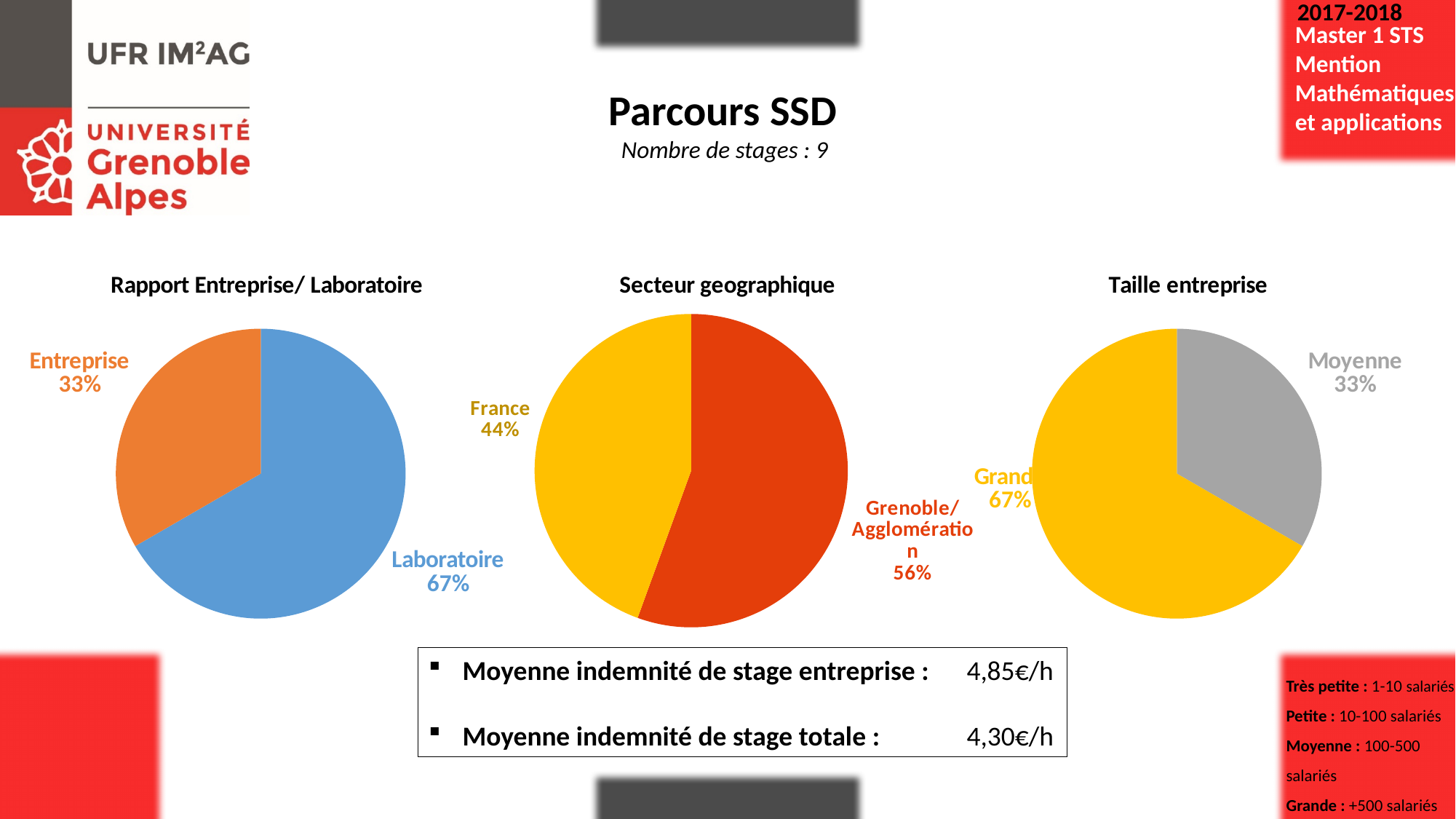
In the 'Secteur geographique' chart, what share does France have? 44% In the 'Rapport Entreprise/ Laboratoire' chart, what share does Laboratoire have? 67% What type of chart is the 'Secteur geographique' chart? Pie chart In the 'Taille entreprise' chart, which is larger, Grande or Moyenne? Grande In the 'Taille entreprise' chart, what share does Grande have? 67% In the 'Secteur geographique' chart, what is the difference in percentage points between Grenoble/Agglomération and France? 12 In the 'Rapport Entreprise/ Laboratoire' chart, which slice is the smallest? Entreprise In the 'Secteur geographique' chart, which slice is the largest? Grenoble/Agglomération How many slices does the 'Taille entreprise' chart have? 2